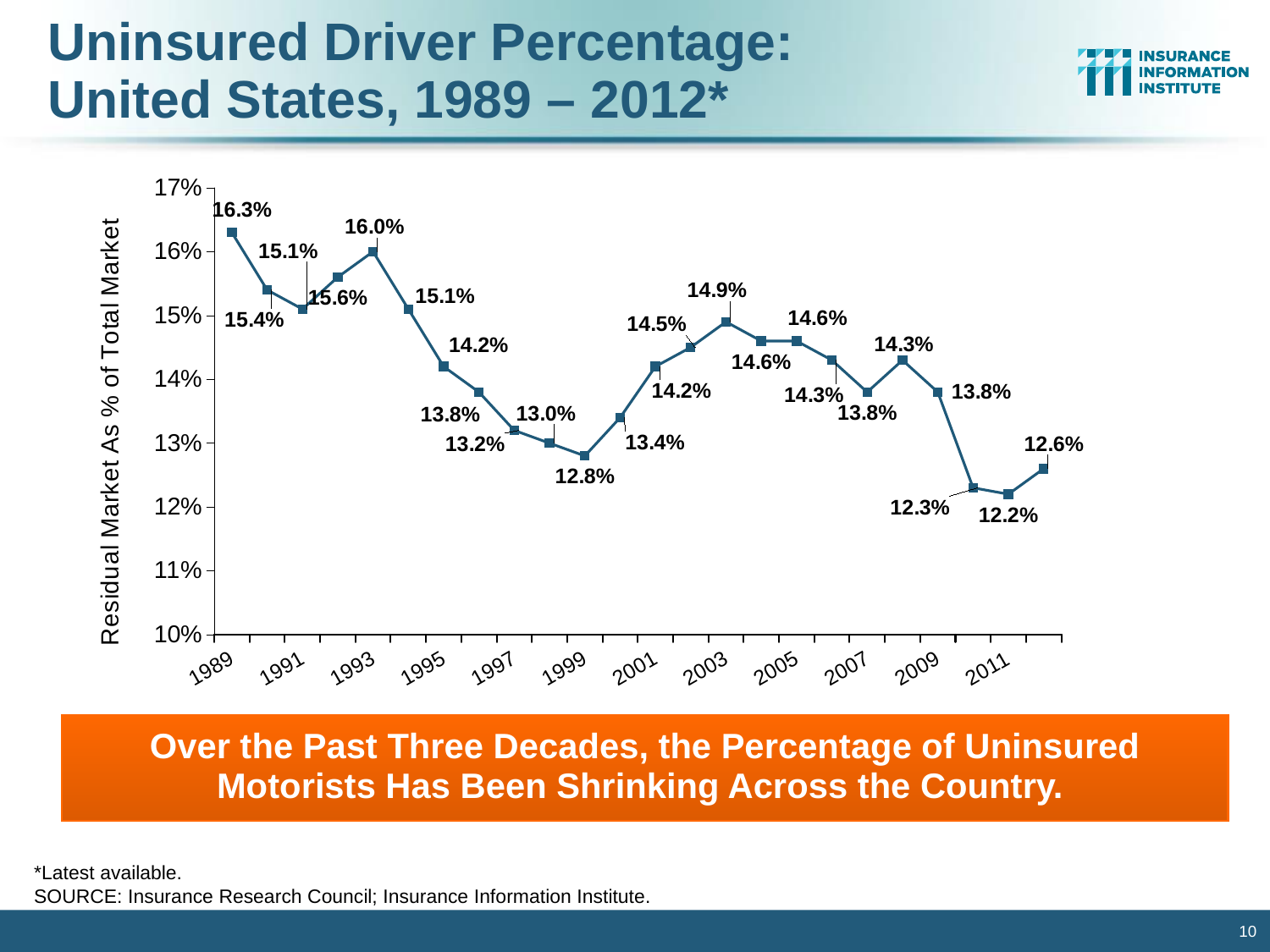
What was the uninsured driver percentage in 1989? 16.3% What type of chart is shown on the slide? Line chart What was the uninsured driver percentage in 1993? 16.0% What was the uninsured driver percentage in 1999? 12.8% Which year had a higher uninsured driver percentage, 1993 or 2003? 1993 In which year was the uninsured driver percentage highest? 1989 In which year was the uninsured driver percentage lowest? 2011 What was the uninsured driver percentage in 2011? 12.2% By how many percentage points did the uninsured driver percentage fall from 1989 (16.3%) to 2012 (12.6%)? 3.7 percentage points What is the overall trend of the uninsured driver percentage from 1989 to 2012? Falling What was the uninsured driver percentage in 2003? 14.9% What is the label on the vertical axis of the chart? Residual Market As % of Total Market